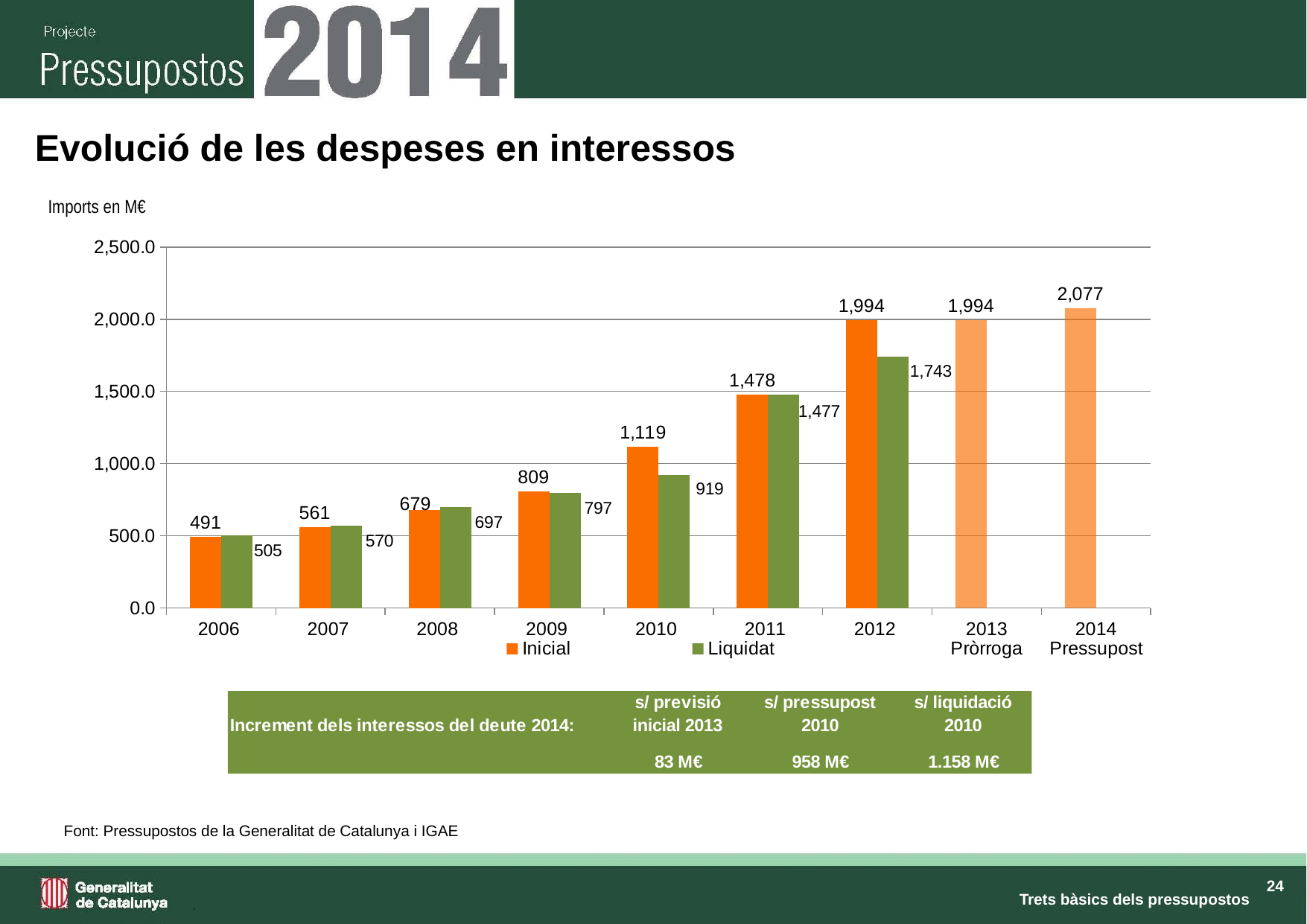
Which is larger for 2009, the Inicial value or the Liquidat value? Inicial What is the value shown for 2014 Pressupost? 2,077 Which category has the highest value on the chart? 2014 Pressupost What is the Inicial value for 2010? 1,119 What is the Liquidat value for 2012? 1,743 What is the difference between the Inicial and Liquidat values for 2010? 200 Do the Inicial values rise or fall from 2006 to 2014? Rise Which category has the lowest Inicial value? 2006 How many series does the legend list? 2 What is the Liquidat value for 2006? 505 How many categories are shown on the x axis? 9 What kind of chart is shown on the slide? Bar chart